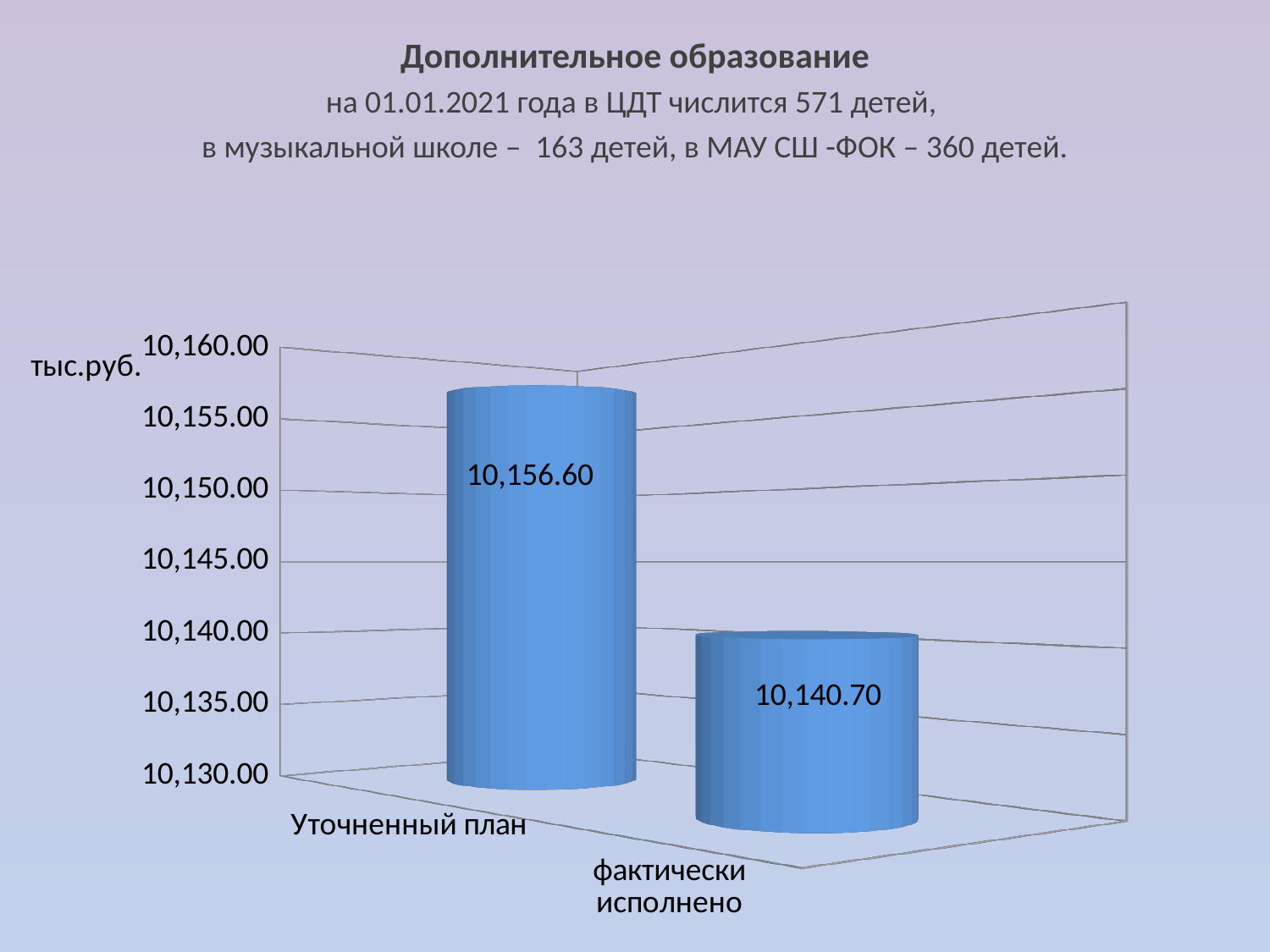
Which category has the highest value? Уточненный план Is the value for фактически исполнено greater or less than 10,145.00? less Which category has the lowest value? фактически исполнено Which is larger, Уточненный план or фактически исполнено? Уточненный план What is the value for фактически исполнено? 10,140.70 What unit is shown next to the vertical axis of the chart? тыс.руб. What is the value for Уточненный план? 10,156.60 Is the value for Уточненный план greater or less than 10,150.00? greater Do the values rise or fall from Уточненный план to фактически исполнено? fall How many categories are shown in the chart? 2 What kind of chart is shown on the slide? bar chart What is the difference between Уточненный план and фактически исполнено? 15.90